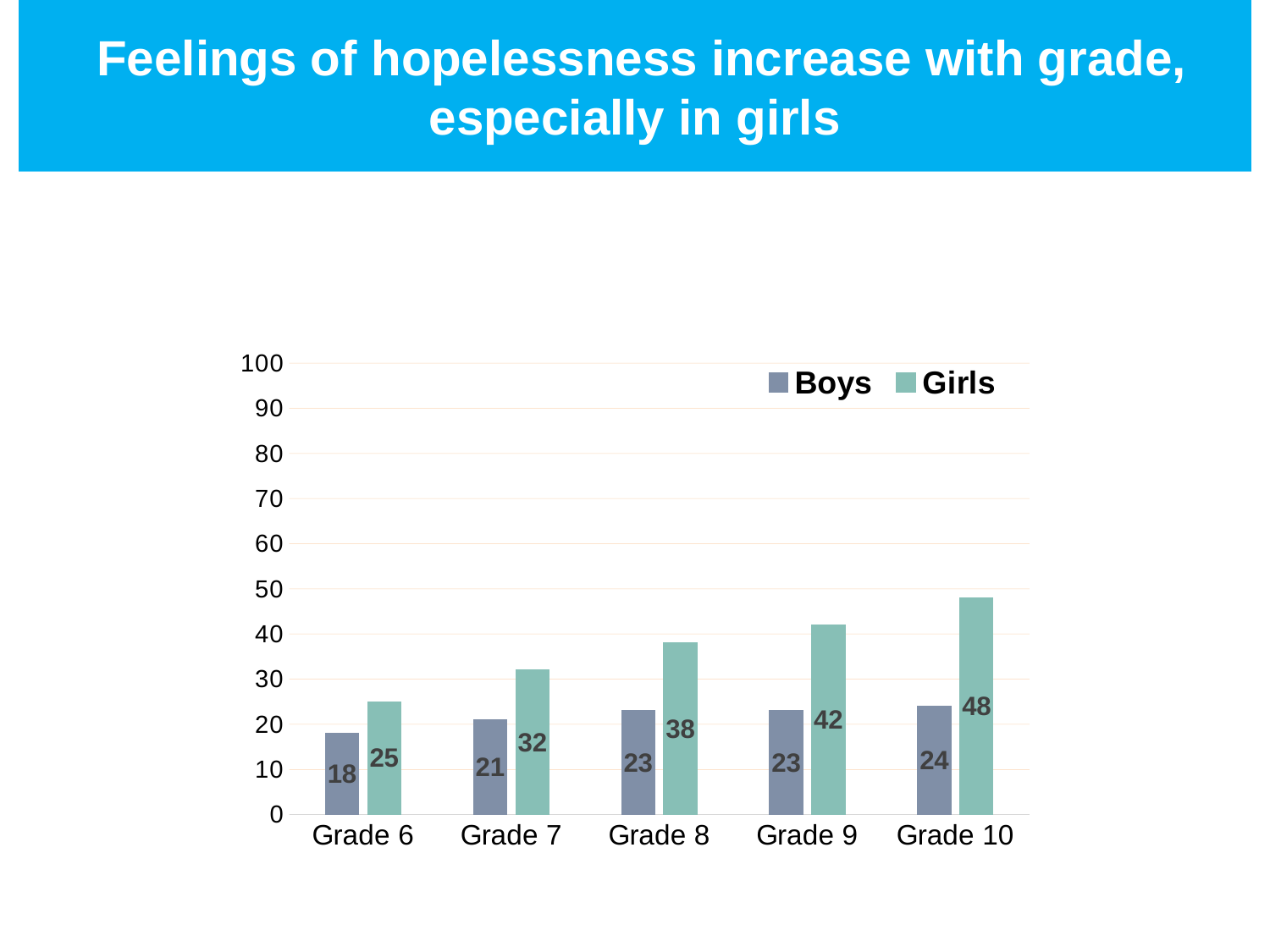
What is the difference between the Girls values for Grade 9 and Grade 6? 17 Which is larger in Grade 7, the value for Boys or the value for Girls? Girls What kind of chart is shown on the slide? Bar chart What is the value for Boys in Grade 6? 18 How many series does the legend list? 2 What is the value for Girls in Grade 8? 38 What is the value for Boys in Grade 10? 24 Which grade has the highest value for Girls? Grade 10 Is the value for Girls in Grade 10 greater or less than 50? less What is the difference between the Girls and Boys values in Grade 10? 24 How many grade categories are shown on the x axis? 5 Which grade has the lowest value for Boys? Grade 6